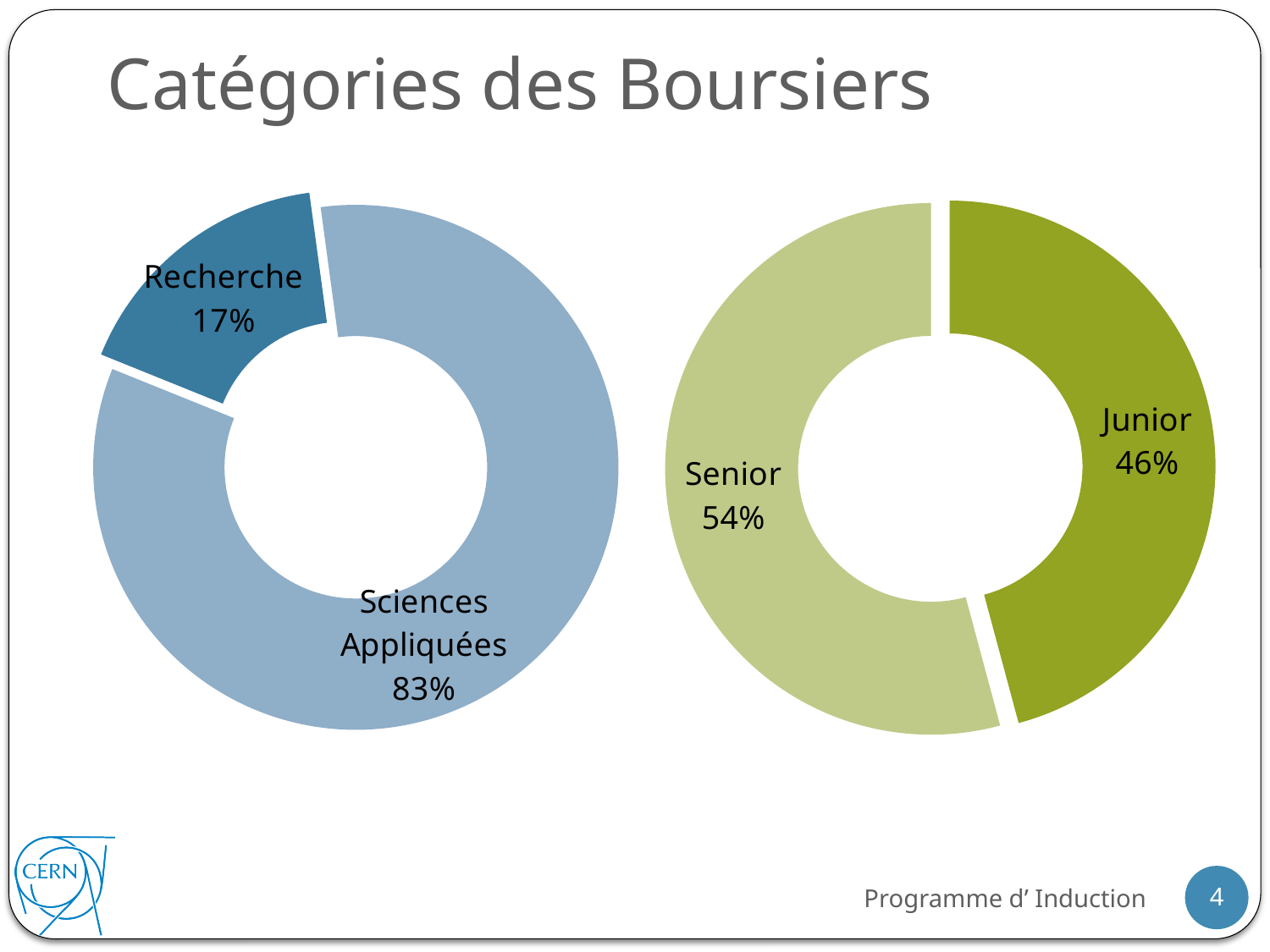
What kind of chart is the right chart? Doughnut chart In the right chart, which is larger, Senior or Junior? Senior In the right chart, what share is labelled for Senior? 54% In the left chart, which category has the largest share? Sciences Appliquées In the right chart, what is the difference between the Senior share and the Junior share? 8% In the left chart, what is the difference between the Sciences Appliquées share and the Recherche share? 66% In the left chart, what share is labelled for Sciences Appliquées? 83% How many slices does the left chart have? 2 In the left chart, what share is labelled for Recherche? 17% In the right chart, what share is labelled for Junior? 46% In the right chart, which category has the smallest share? Junior What is the title of the slide containing the two charts? Catégories des Boursiers